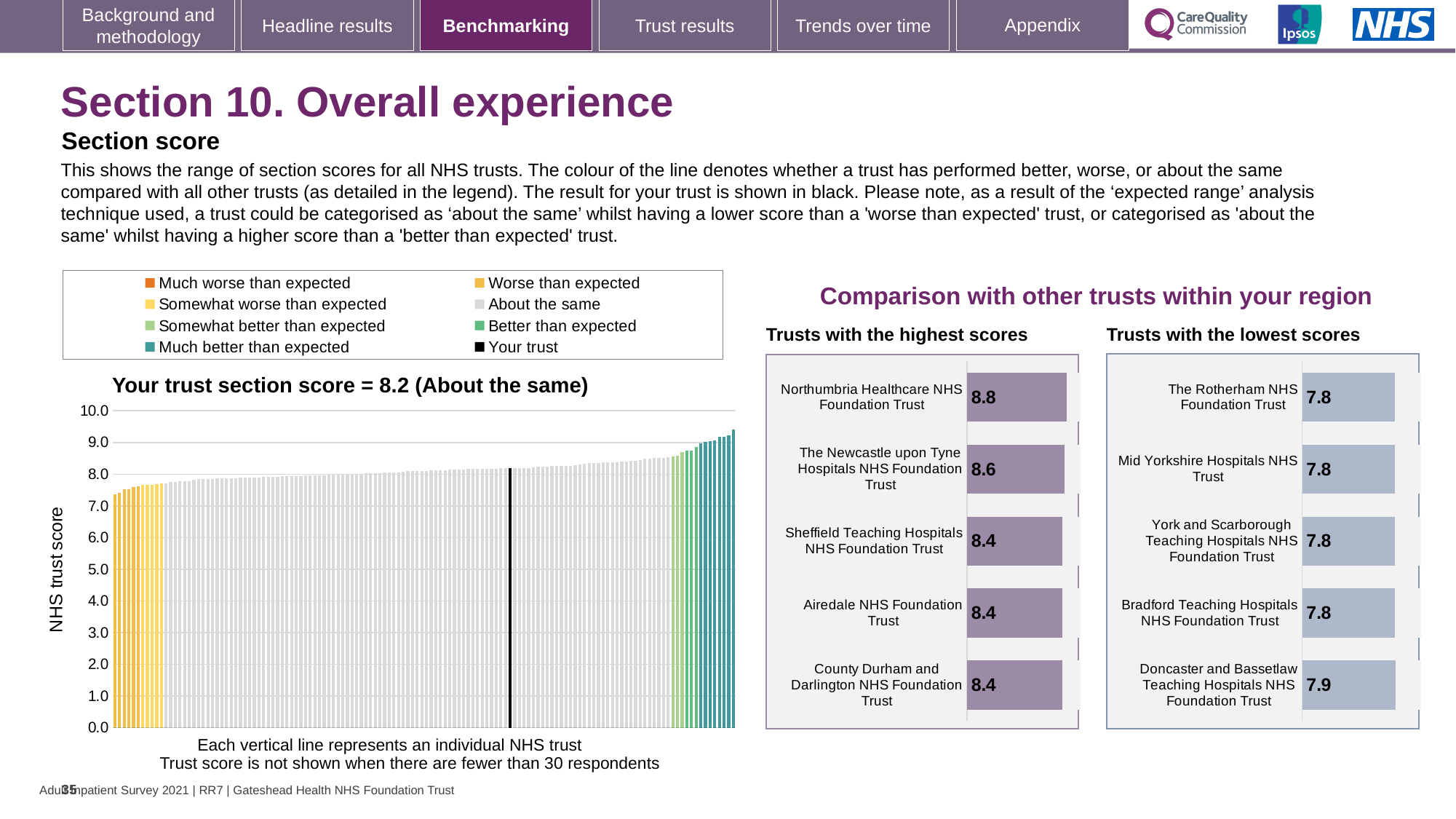
In the 'Your trust section score' chart, what is the section score for your trust? 8.2 In the 'Trusts with the highest scores' chart, what is the score for The Newcastle upon Tyne Hospitals NHS Foundation Trust? 8.6 In the 'Trusts with the lowest scores' chart, which trust has the highest score? Doncaster and Bassetlaw Teaching Hospitals NHS Foundation Trust What kind of chart is the 'Your trust section score' chart on the left? bar chart In the 'Trusts with the highest scores' chart, what is the difference between the scores of Northumbria Healthcare NHS Foundation Trust and Sheffield Teaching Hospitals NHS Foundation Trust? 0.4 In the 'Your trust section score' chart, how many entries does the legend list? 8 In the 'Your trust section score' chart, is the value of the leftmost (lowest) bar greater or less than 7.0? greater In the 'Trusts with the highest scores' chart, which trust has the highest score? Northumbria Healthcare NHS Foundation Trust In the 'Your trust section score' chart, do the trust scores rise or fall from left to right along the x axis? rise In the 'Your trust section score' chart, is the value of the rightmost (highest) bar greater or less than 10.0? less In the 'Trusts with the lowest scores' chart, what is the score for Bradford Teaching Hospitals NHS Foundation Trust? 7.8 In the 'Trusts with the highest scores' chart, how many trusts are shown? 5